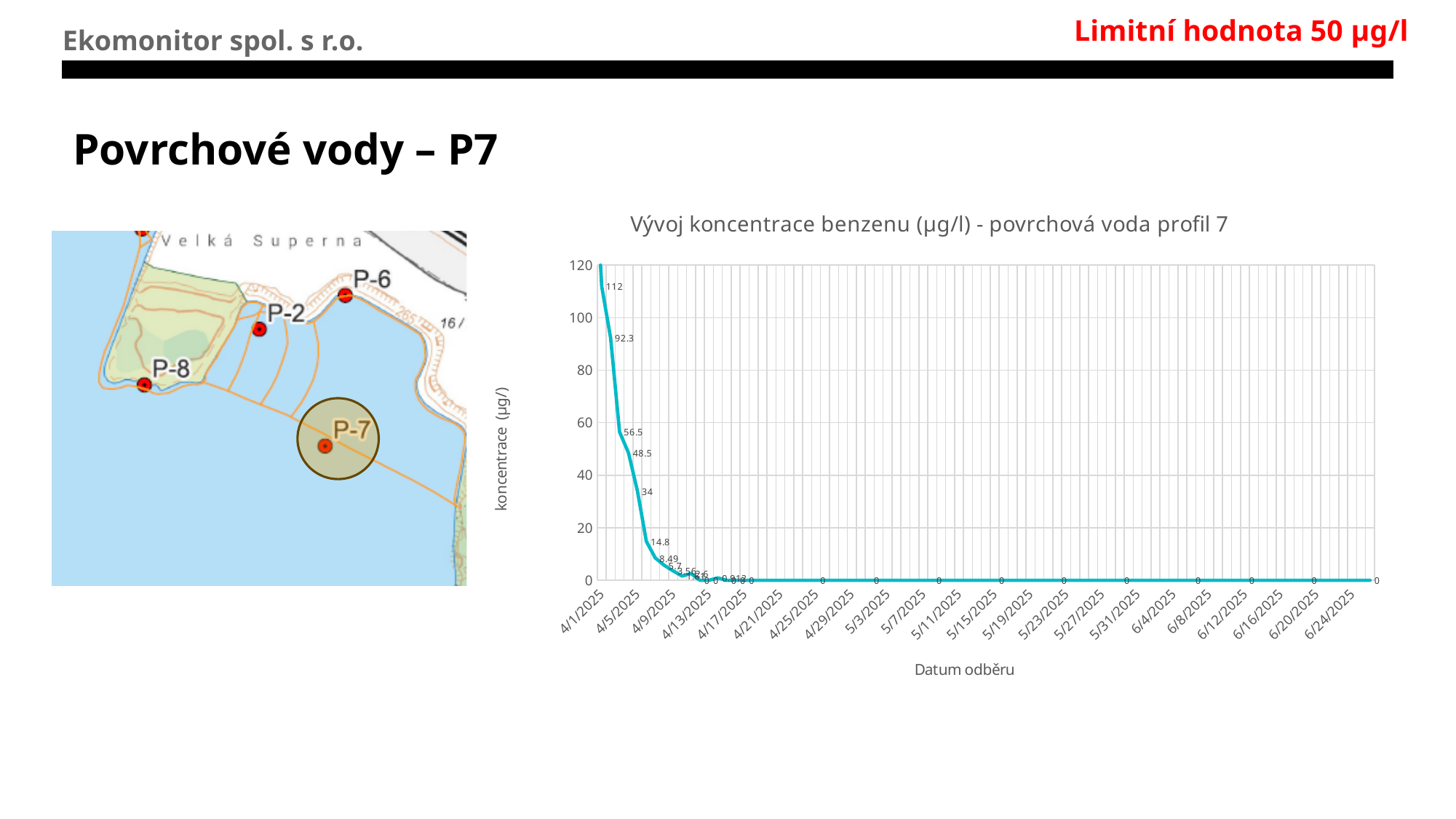
Do the values rise or fall along the x axis from 4/1/2025 onward? fall What is the highest value plotted on the chart? 112 What is the label of the x axis? Datum odběru What is the title of the chart? Vývoj koncentrace benzenu (µg/l) - povrchová voda profil 7 What is the benzene concentration value shown for 4/1/2025? 112 Is the value for 4/5/2025 greater or less than 60? less Which date has the larger value, 4/1/2025 or 4/5/2025? 4/1/2025 What type of chart is shown on the slide? line chart What is the difference between the first two data points, 112 and 92.3? 19.7 What value is shown for the last data point on the chart? 0 Is the value for 4/9/2025 greater or less than 20? less What is the lowest value plotted on the chart? 0